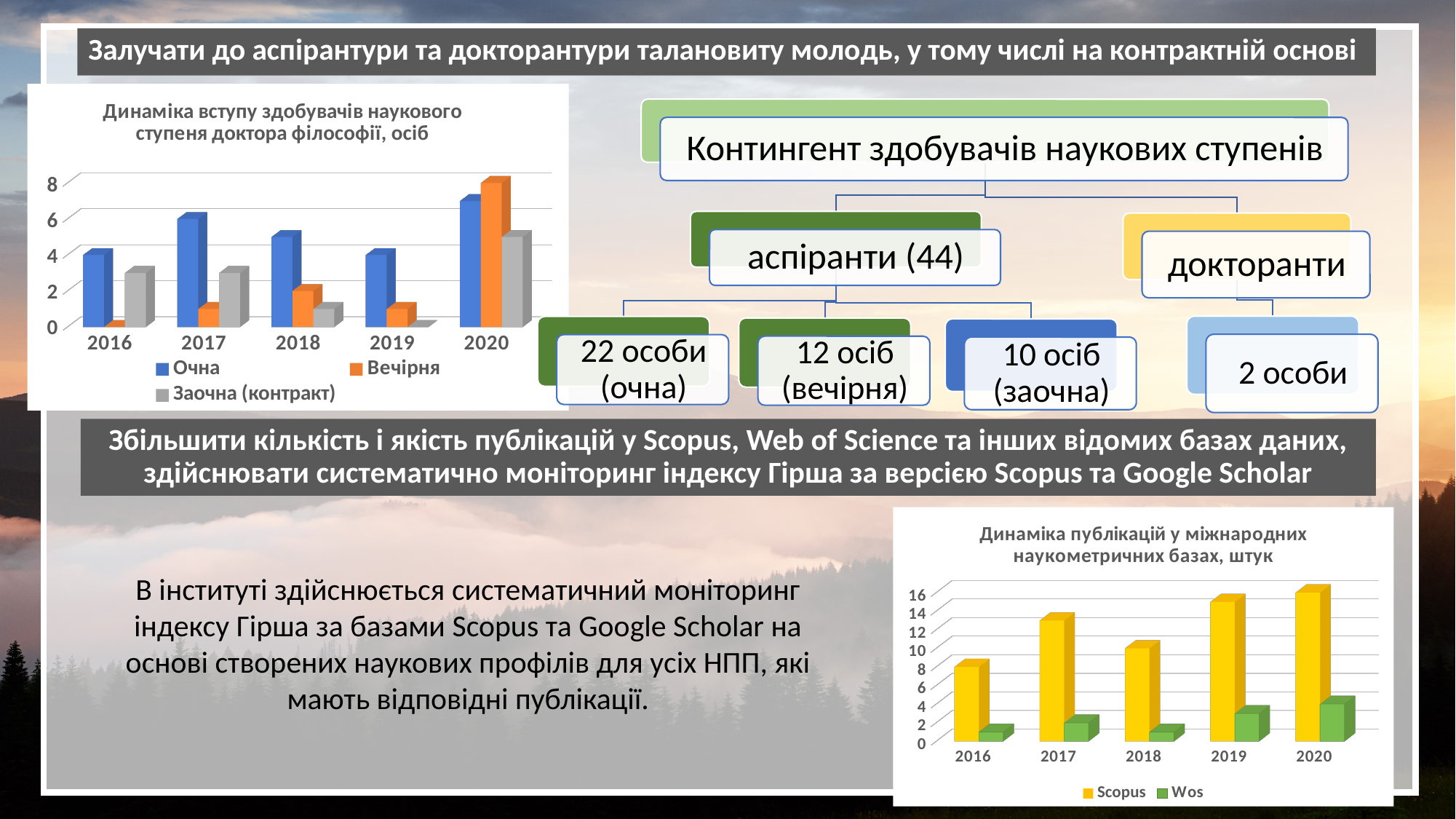
What kind of chart is the chart titled "Динаміка вступу здобувачів наукового ступеня доктора філософії, осіб"? bar chart In the chart "Динаміка публікацій у міжнародних наукометричних базах, штук", which is larger: Scopus in 2018 or Scopus in 2019? Scopus in 2019 What kind of chart is the chart titled "Динаміка публікацій у міжнародних наукометричних базах, штук"? bar chart In the chart "Динаміка вступу здобувачів наукового ступеня доктора філософії, осіб", which is larger: Очна in 2017 or Очна in 2019? Очна in 2017 In the chart "Динаміка публікацій у міжнародних наукометричних базах, штук", what are the two legend entries? Scopus, Wos In the chart "Динаміка публікацій у міжнародних наукометричних базах, штук", how many series does the legend list? 2 In the chart "Динаміка вступу здобувачів наукового ступеня доктора філософії, осіб", how many years are shown on the x axis? 5 In the chart "Динаміка вступу здобувачів наукового ступеня доктора філософії, осіб", how many series does the legend list? 3 In the chart "Динаміка публікацій у міжнародних наукометричних базах, штук", is the value for Scopus in 2017 greater or less than 12? greater In the chart "Динаміка вступу здобувачів наукового ступеня доктора філософії, осіб", is the value for Вечірня in 2020 greater or less than 6? greater In the chart "Динаміка публікацій у міжнародних наукометричних базах, штук", which year has the lowest value for Scopus? 2016 In the chart "Динаміка вступу здобувачів наукового ступеня доктора філософії, осіб", which year has the highest value for Очна? 2020